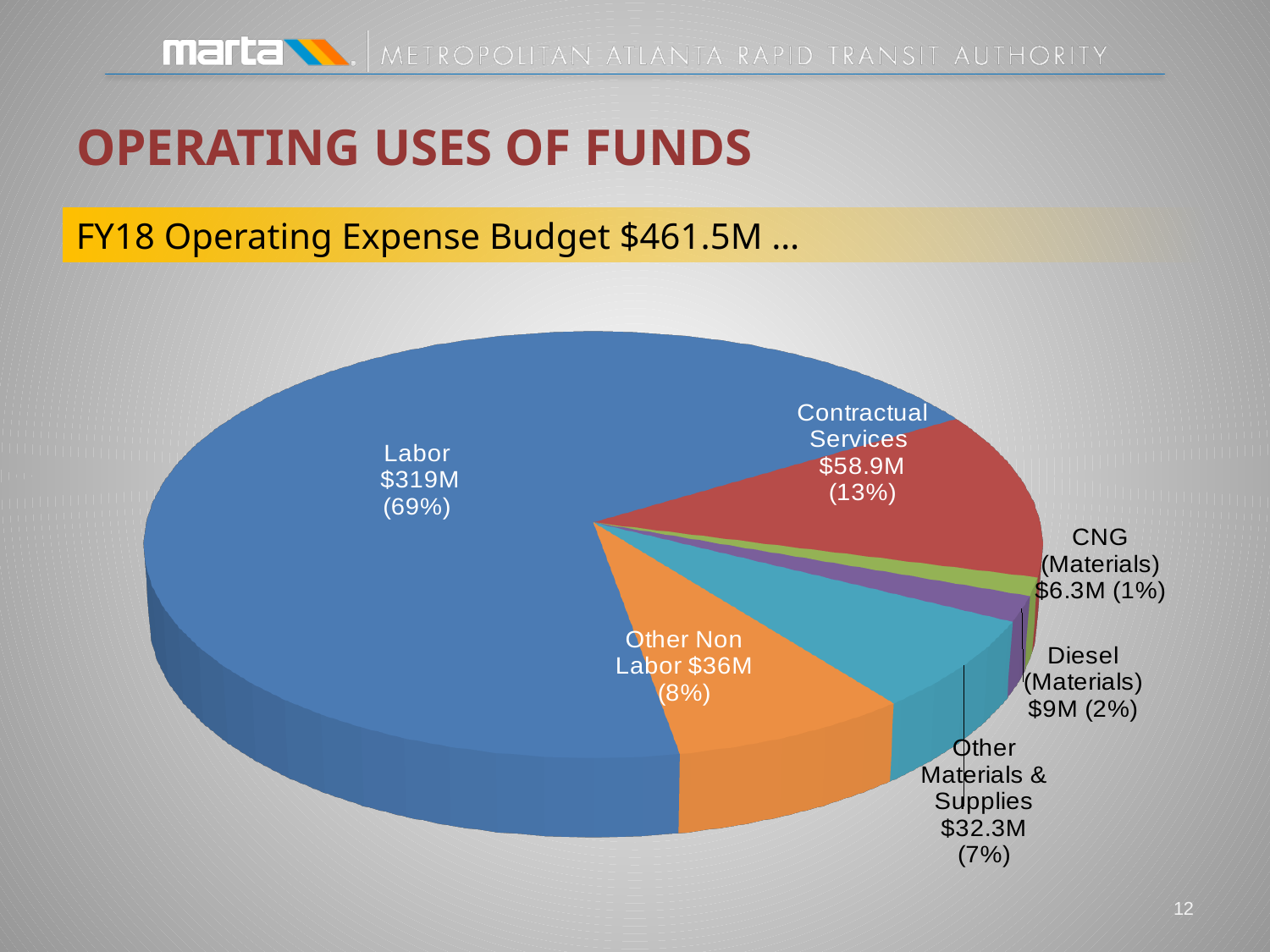
What kind of chart is shown on the slide? Pie chart What is the difference between the Diesel (Materials) and CNG (Materials) values? $2.7M What is the value for Contractual Services? $58.9M What is the value for Diesel (Materials)? $9M How many slices does the pie chart have? 6 Which category has the largest slice? Labor What is the value for Other Materials & Supplies? $32.3M Which is larger, Other Non Labor or Other Materials & Supplies? Other Non Labor What is the value for Labor? $319M What share of the pie does Contractual Services represent? 13% Which category has the smallest slice? CNG (Materials) What share of the pie does Other Non Labor represent? 8%